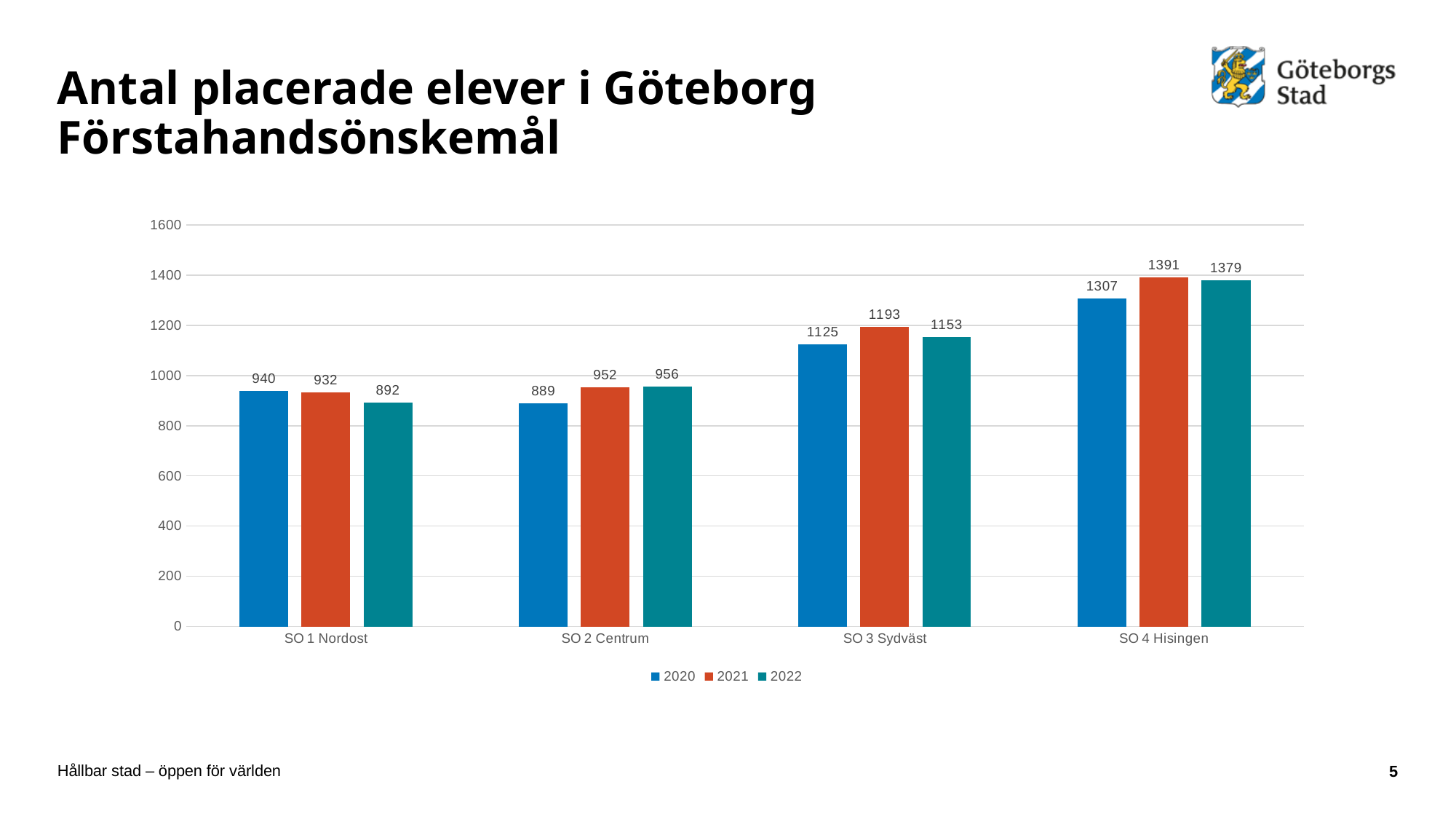
Which category has the lowest value in 2022? SO 1 Nordost How many series does the legend list? 3 What is the value for SO 1 Nordost in 2020? 940 Which is larger for SO 2 Centrum: the 2021 value or the 2022 value? 2022 What is the difference between the 2021 and 2020 values for SO 4 Hisingen? 84 How many categories are shown on the x axis? 4 What is the value for SO 2 Centrum in 2020? 889 Which series is shown in orange in the legend? 2021 Which category has the highest value in 2021? SO 4 Hisingen What is the value for SO 4 Hisingen in 2022? 1379 What is the value for SO 3 Sydväst in 2021? 1193 What kind of chart is shown on the slide? Bar chart